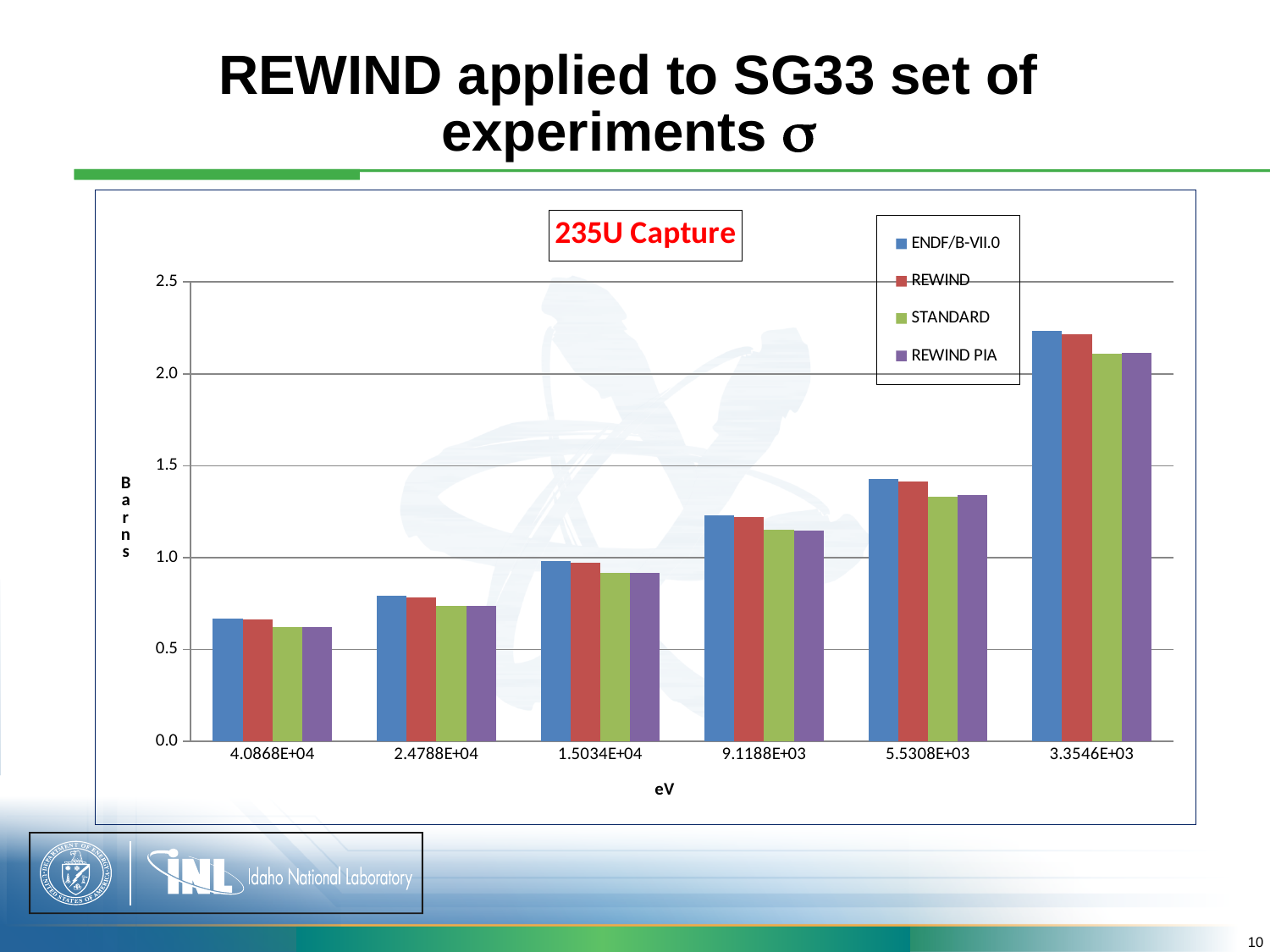
How many series does the legend of the 235U Capture chart list? 4 Which energy category has the highest ENDF/B-VII.0 value? 3.3546E+03 Is the STANDARD value for 4.0868E+04 greater or less than 1.0? less Which is larger for the REWIND series: the value at 5.5308E+03 or the value at 9.1188E+03? 5.5308E+03 What is the label on the y axis of the chart? Barns Is the ENDF/B-VII.0 value for 9.1188E+03 greater or less than 1.0? greater Do the bar values rise or fall moving from left to right along the x axis? rise How many energy categories are shown on the x axis of the 235U Capture chart? 6 Which is larger at 3.3546E+03: the ENDF/B-VII.0 value or the STANDARD value? ENDF/B-VII.0 Which energy category has the lowest STANDARD value? 4.0868E+04 Is the ENDF/B-VII.0 value for 3.3546E+03 greater or less than 2.0? greater What kind of chart is shown on the slide? bar chart